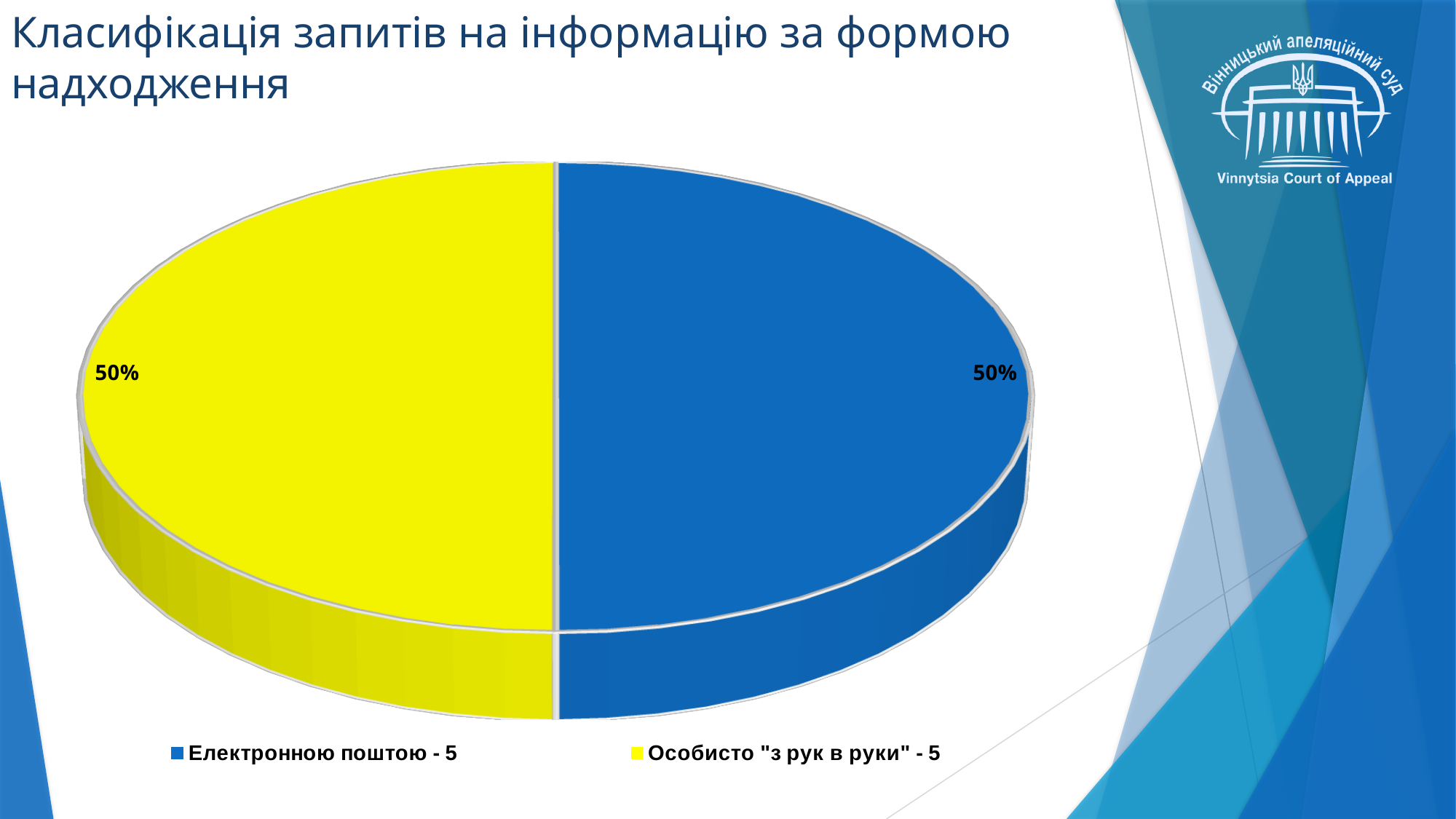
What is the title of the slide containing the pie chart? Класифікація запитів на інформацію за формою надходження What is the difference between the percentage shown for "Електронною поштою" and the percentage shown for "Особисто "з рук в руки""? 0% How many slices does the pie chart have? 2 What is the total number of requests across both legend categories? 10 Which is larger: the share for "Електронною поштою" or the share for "Особисто "з рук в руки""? They are equal What share of the pie does the slice "Особисто "з рук в руки" - 5" represent? 50% What share of the pie does the slice "Електронною поштою - 5" represent? 50% According to the legend, how many requests were received "Особисто "з рук в руки""? 5 How many entries does the legend list? 2 What colour is the slice for "Електронною поштою - 5"? Blue What kind of chart is shown on the slide? Pie chart According to the legend, how many requests were received by "Електронною поштою"? 5